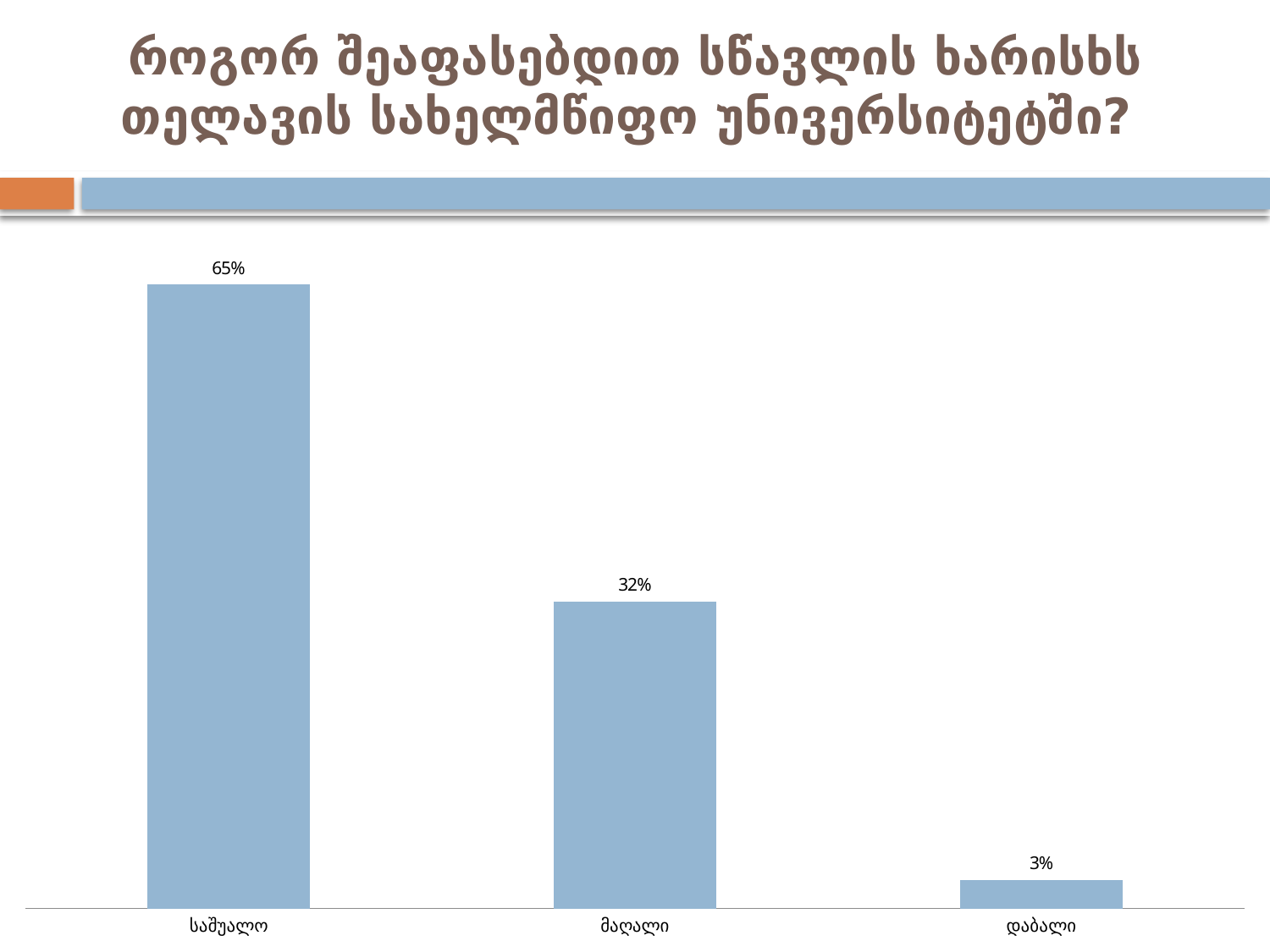
Which is larger, the value for მაღალი or the value for დაბალი? მაღალი Which category has the lowest value? დაბალი What is the value for მაღალი? 32% What is the value for საშუალო? 65% What is the value for დაბალი? 3% What kind of chart is shown on the slide? bar chart How many categories are shown in the chart? 3 Do the values rise or fall from left to right across the categories? fall What is the difference between the values for მაღალი and დაბალი? 29% What is the title of the slide? როგორ შეაფასებდით სწავლის ხარისხს თელავის სახელმწიფო უნივერსიტეტში? What is the difference between the values for საშუალო and მაღალი? 33% Which category has the highest value? საშუალო